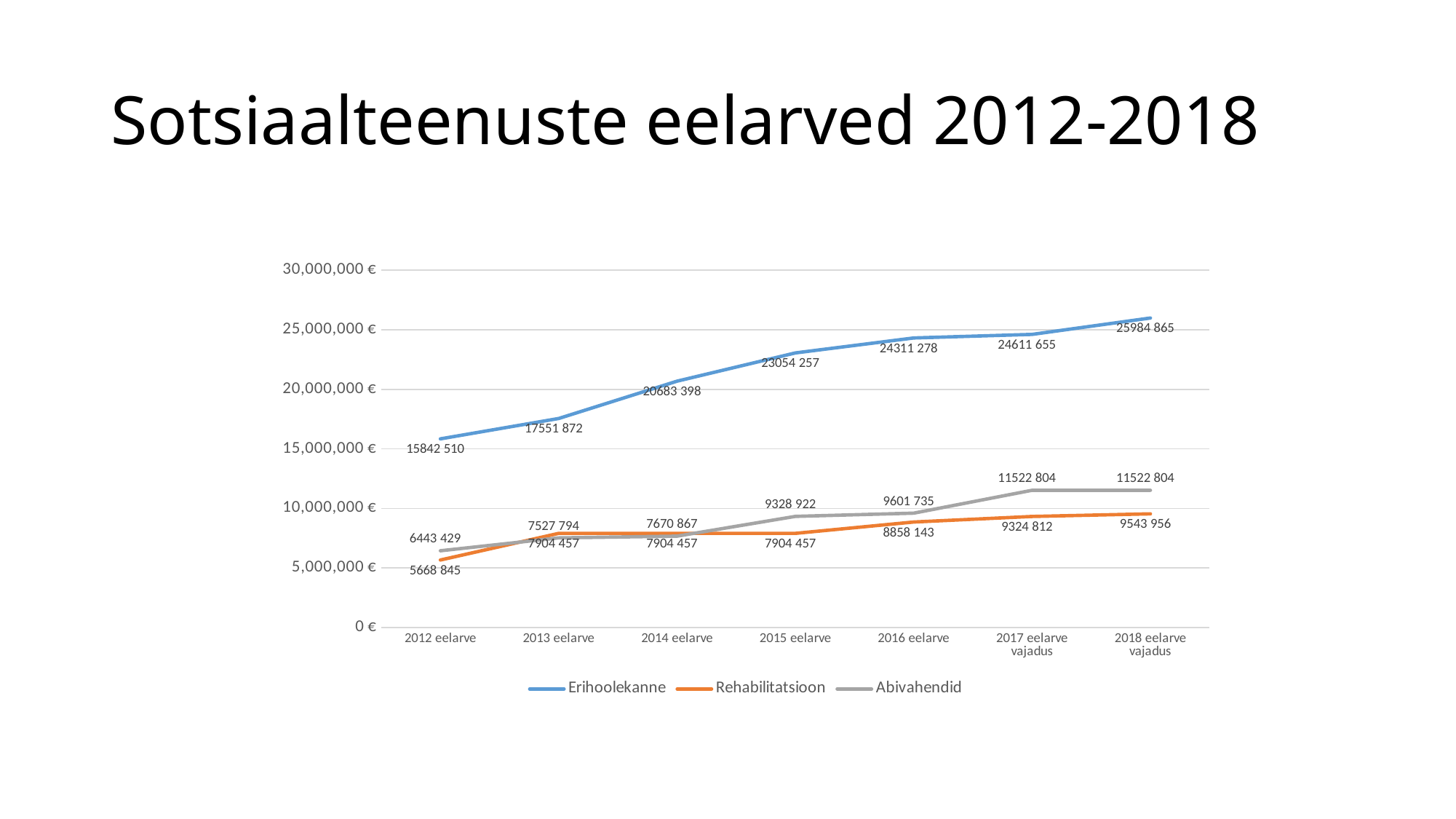
What is the value for Abivahendid in 2017 eelarve vajadus? 11522 804 Which series has the lowest value in 2012 eelarve? Rehabilitatsioon What kind of chart is shown on the slide? line chart Which series has the highest value in 2018 eelarve vajadus? Erihoolekanne What is the value for Rehabilitatsioon in 2018 eelarve vajadus? 9543 956 In 2015 eelarve, which is larger: Abivahendid or Rehabilitatsioon? Abivahendid How many categories are shown on the x axis? 7 Is the value for Erihoolekanne in 2014 eelarve greater or less than 20,000,000 €? greater What is the difference between the Erihoolekanne values for 2018 eelarve vajadus and 2012 eelarve? 10142 355 What is the value for Erihoolekanne in 2012 eelarve? 15842 510 How many series does the legend list? 3 Does the Erihoolekanne line rise or fall from 2012 eelarve to 2018 eelarve vajadus? rise